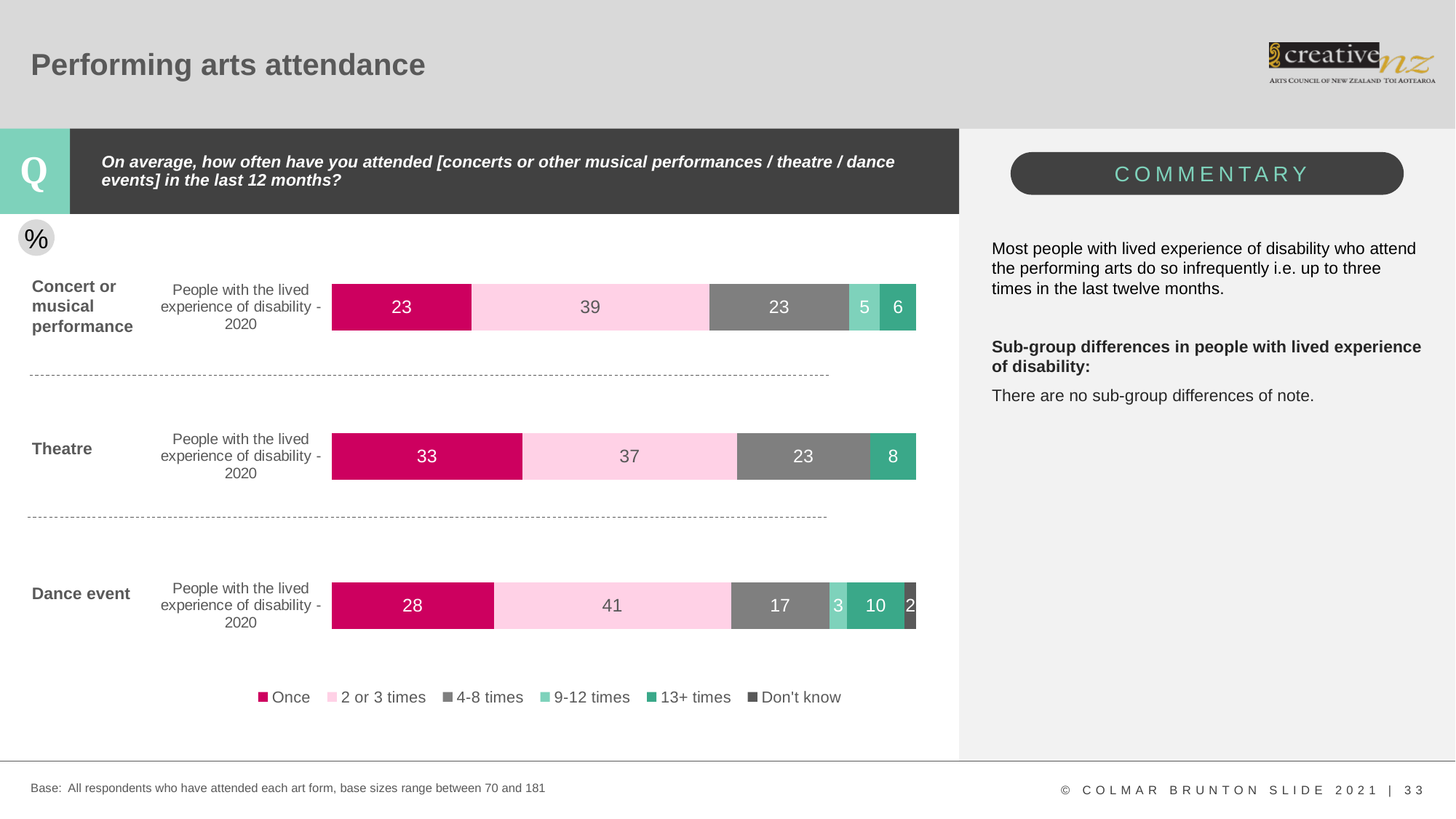
In the Dance event chart, what is the value for '13+ times'? 10 Is the 'Once' value larger in the Theatre chart or the Dance event chart? Theatre In the Concert or musical performance chart, which attendance frequency has the lowest value? 9-12 times In the Theatre chart, what is the difference between the 'Once' value and the '4-8 times' value? 10 In the Dance event chart, what is the total of all the labelled segments in the bar? 101 Which legend entry is shown in the darkest grey colour? Don't know How many series does the legend list? 6 In the Concert or musical performance chart, what percentage of people with lived experience of disability attended once? 23 What kind of chart is used to show the attendance frequencies? Stacked bar chart In the Theatre chart, what is the value for '2 or 3 times'? 37 How many art forms (bars) are shown on the slide? 3 In the Dance event chart, which attendance frequency has the highest value? 2 or 3 times